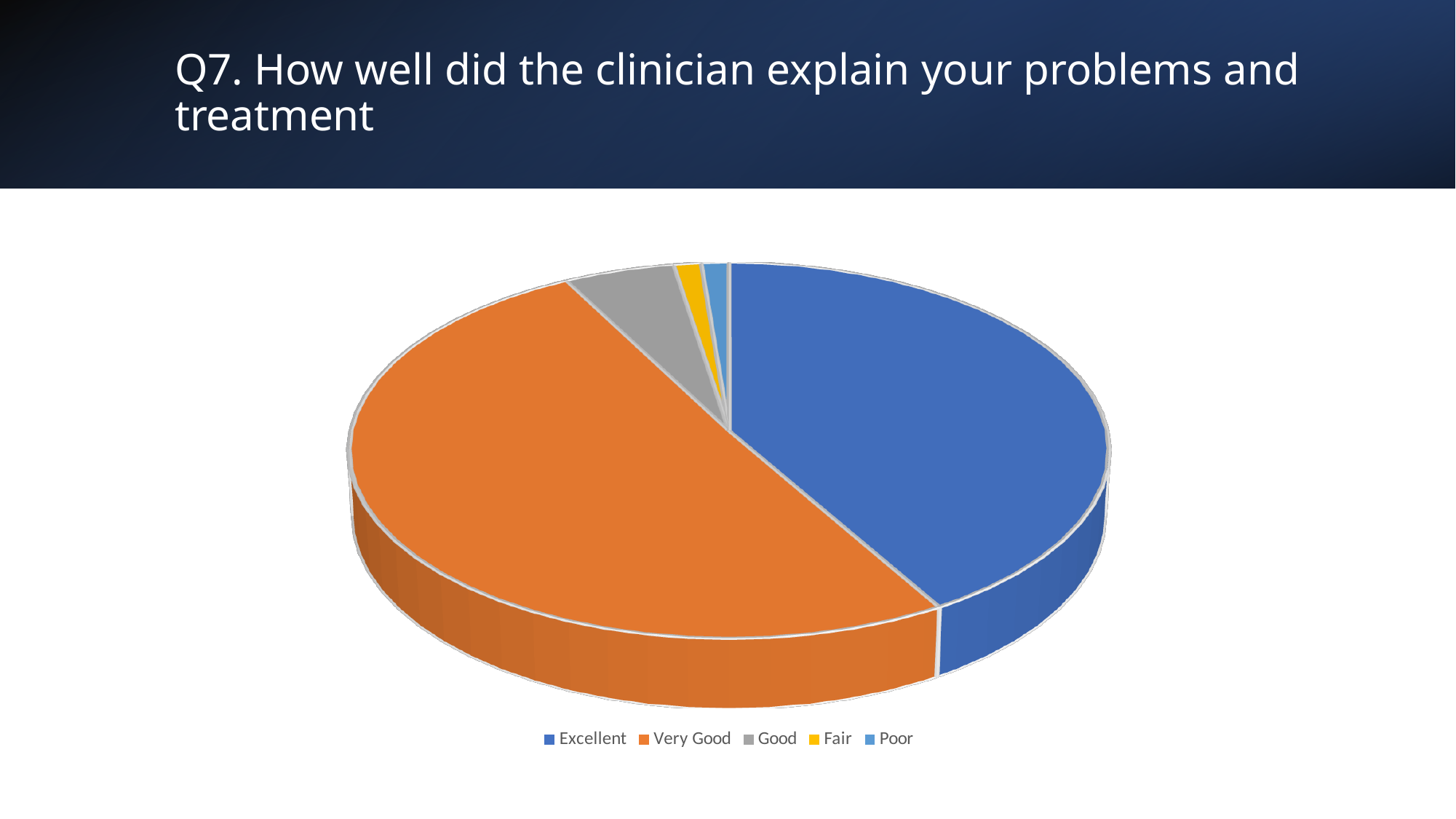
How many categories does the legend of the pie chart list? 5 Which slice is larger, Good or Poor? Good What is the title of the chart on the slide? Q7. How well did the clinician explain your problems and treatment Which slice is larger, Good or Fair? Good Which slice is larger, Very Good or Excellent? Very Good Which category is shown in orange in the pie chart? Very Good What kind of chart is shown on the slide? Pie chart Which category is the second largest slice of the pie chart? Excellent Which category has the largest slice of the pie chart? Very Good